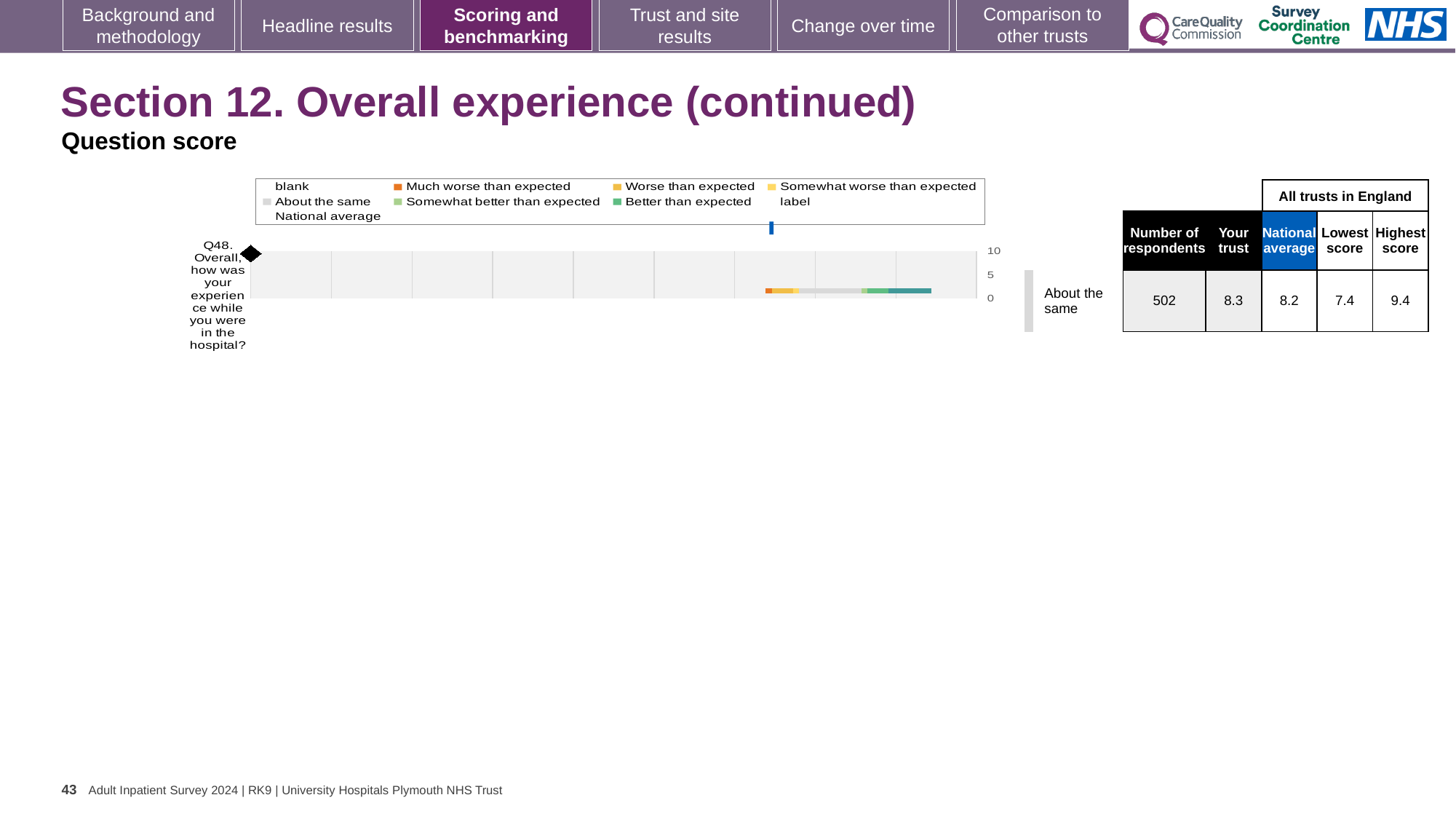
Which benchmark category is the trust's Q48 result labelled as next to the chart? About the same In the table beside the chart, what is the number of respondents for Q48? 502 In the table beside the chart, what is the lowest score among all trusts in England for Q48? 7.4 How many questions (categories) are plotted in the chart? 1 What kind of chart is shown for Q48 on this slide? Bar chart How many entries does the chart legend list? 9 Which is larger for Q48: the 'Your trust' score or the national average? Your trust In the table beside the chart, what is the 'Your trust' score for Q48? 8.3 In the table beside the chart, what is the highest score among all trusts in England for Q48? 9.4 In the table beside the chart, what is the national average score for Q48? 8.2 What is the highest tick value shown on the chart's axis? 10 What is the difference between the highest score and the lowest score for Q48 in the table? 2.0